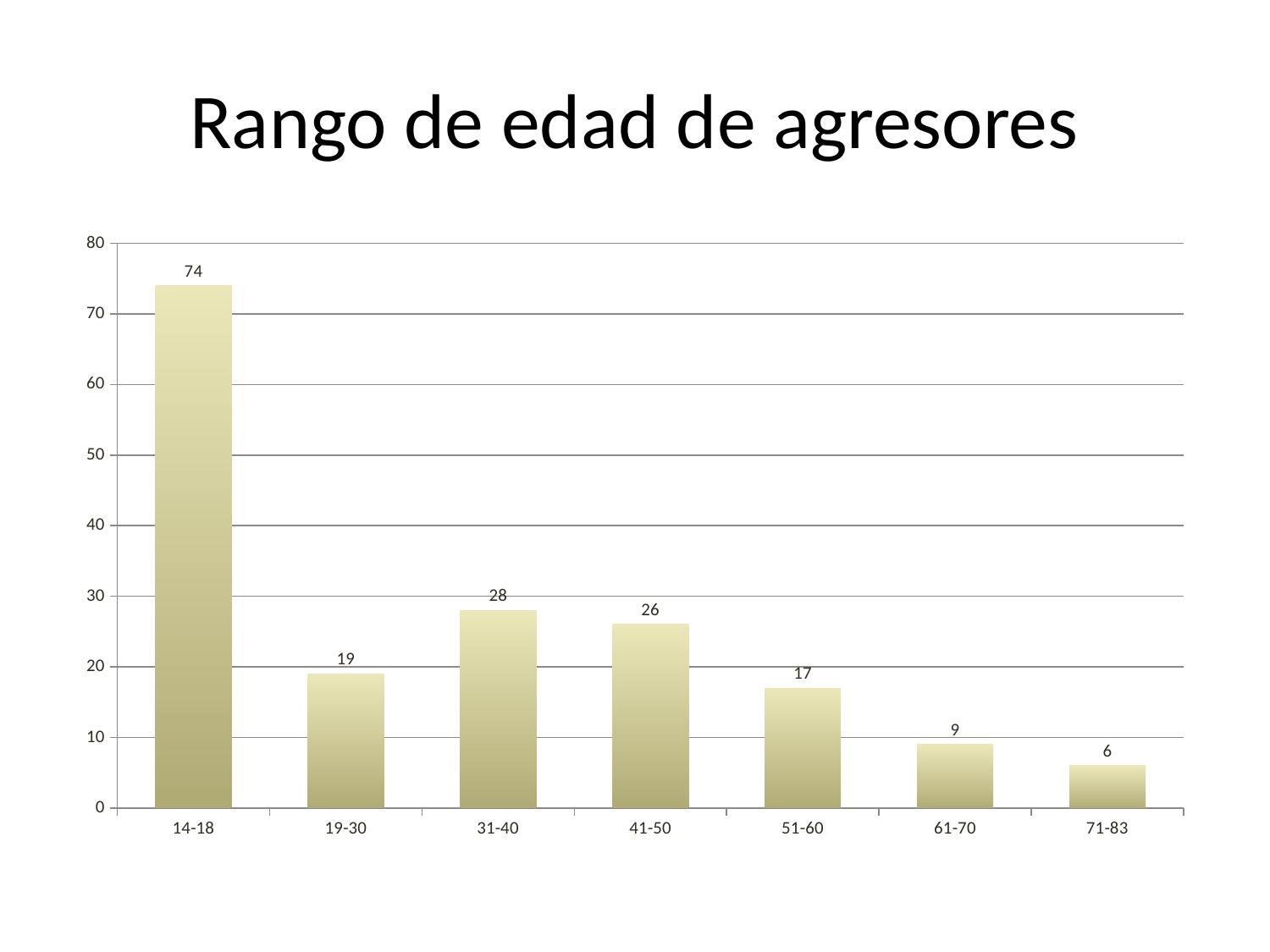
What is the title of the slide? Rango de edad de agresores How many age ranges are shown on the x axis? 7 What is the value for the 71-83 age range? 6 Which is larger, the value for 19-30 or the value for 51-60? 19-30 What kind of chart is shown on the slide? bar chart Which age range has the lowest value? 71-83 Which age range has the highest value? 14-18 What is the value for the 14-18 age range? 74 Is the value for 61-70 greater or less than 10? less What is the value for the 51-60 age range? 17 What is the difference between the values for 31-40 and 41-50? 2 What is the difference between the values for 14-18 and 19-30? 55